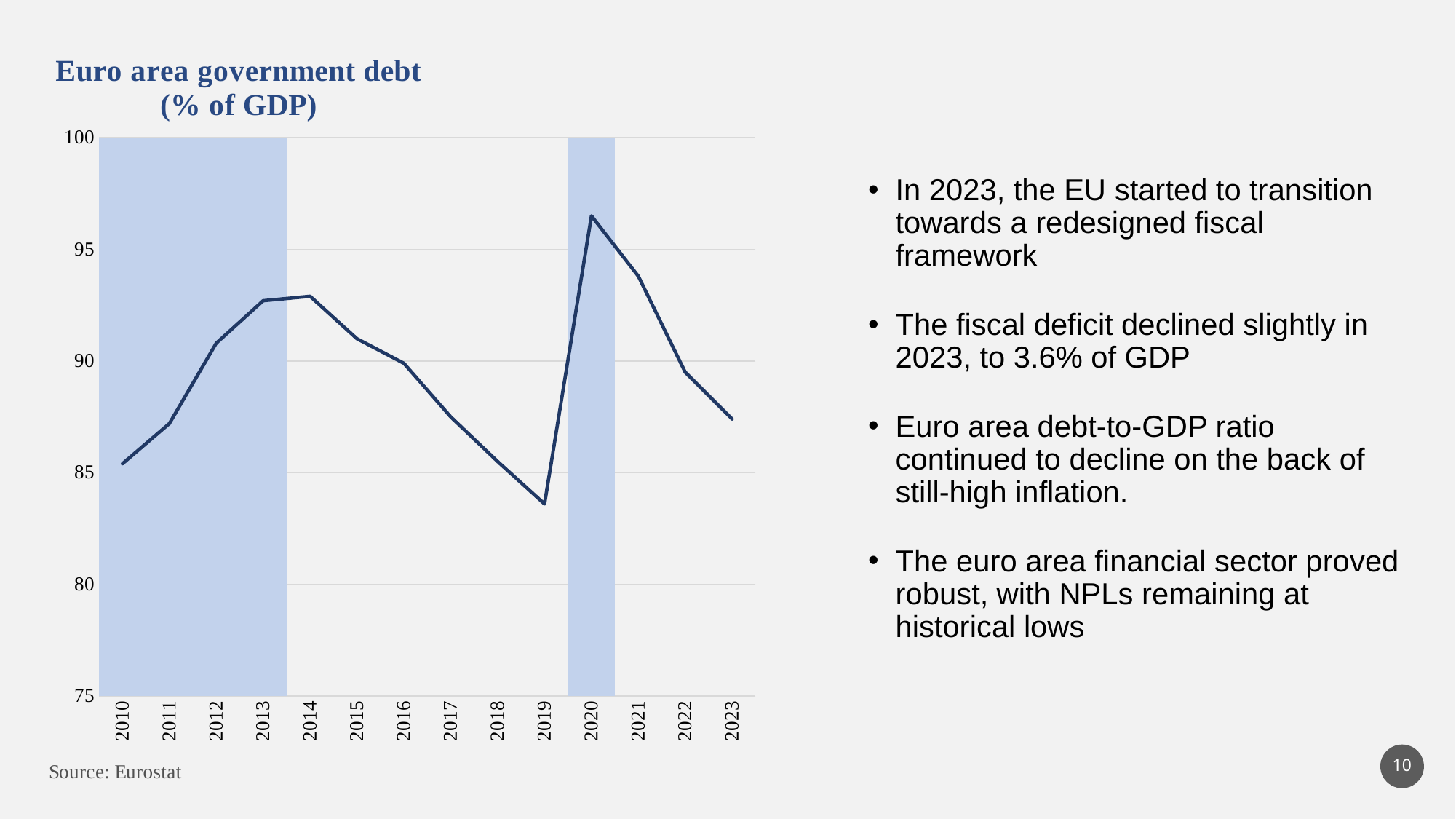
What kind of chart is shown on the slide? line chart Which year has the higher government debt ratio, 2012 or 2018? 2012 Do the values rise or fall between 2020 and 2023? fall Is the value for 2013 greater or less than 90? greater What is the title of the chart? Euro area government debt (% of GDP) In which year does euro area government debt reach its lowest value? 2019 How many years are plotted on the x axis of the chart? 14 Is the value for 2020 greater or less than 95? greater In which year does euro area government debt reach its highest value? 2020 Is the value for 2023 greater or less than 90? less What source is cited for the chart? Eurostat